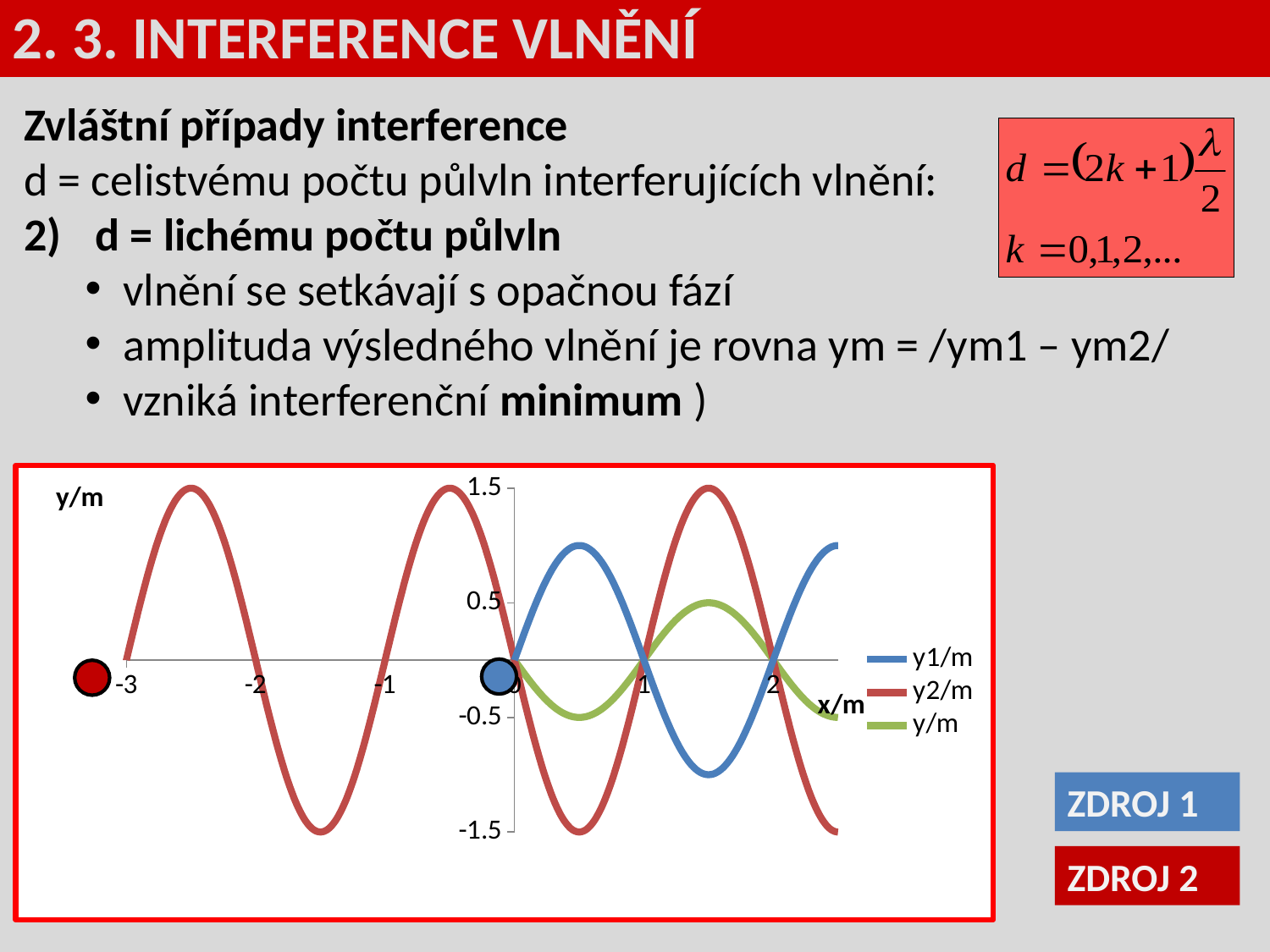
Is the peak value of the y1/m series greater or less than 1.5? less Which series in the chart has the smallest amplitude? y/m Which series has a larger amplitude, y1/m or y/m? y1/m What is the highest value labelled on the vertical axis of the chart? 1.5 Which series in the chart has the largest amplitude? y2/m How many series does the chart legend list? 3 Is the peak value of the y2/m series greater or less than 0.5? greater Is the peak value of the y1/m series greater or less than 0.5? greater Which colour is used for the y2/m series in the chart? red What kind of chart is shown on the slide? line chart What is the lowest value labelled on the horizontal axis of the chart? -3 What are the three series named in the chart legend? y1/m, y2/m, y/m